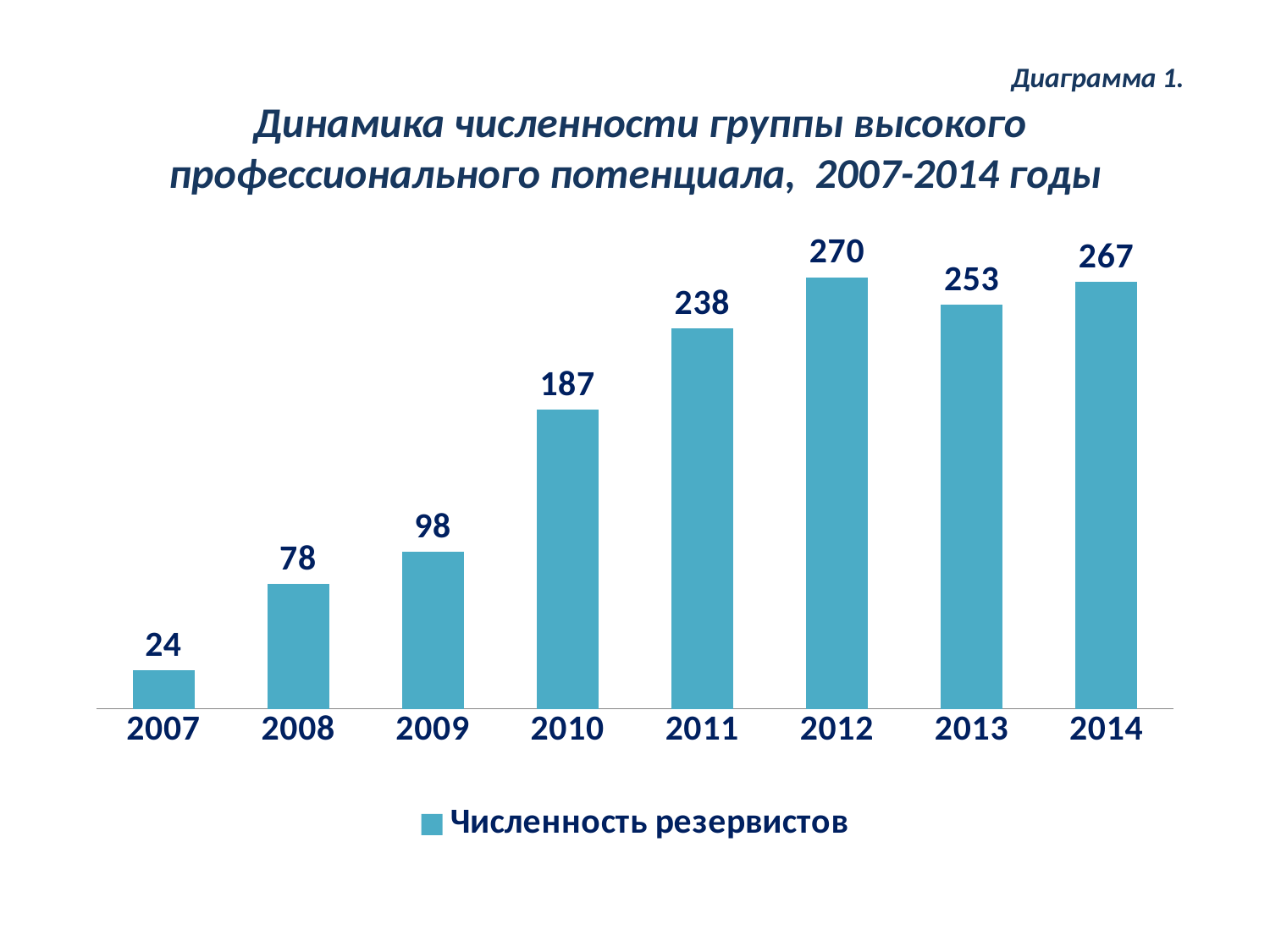
How many series does the legend list? 1 What is the difference between the values for 2012 and 2011? 32 What is the value for 2010? 187 How many years are shown on the x axis? 8 What kind of chart is this? bar chart Which year has the highest value? 2012 Which is larger, the value for 2013 or the value for 2014? 2014 Which year has the lowest value? 2007 What is the value for 2013? 253 What is the difference between the values for 2014 and 2007? 243 What is the legend entry for the series? Численность резервистов What is the value for 2007? 24